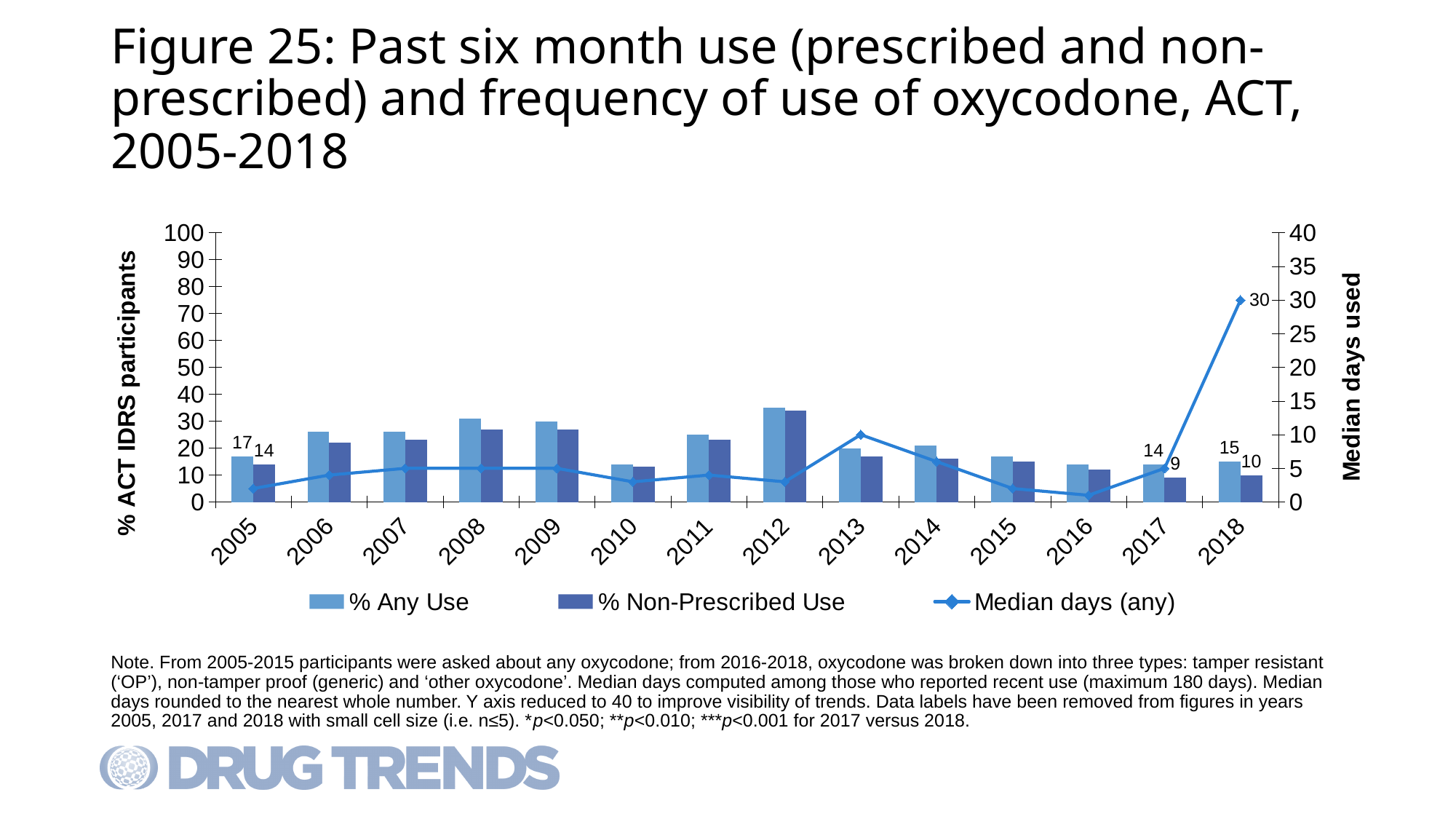
Which year has the larger Median days (any) value, 2013 or 2018? 2018 What is the value for % Any Use in 2018? 15 Which year has the highest % Any Use? 2012 How many series does the legend list? 3 What is the difference between % Any Use and % Non-Prescribed Use in 2018? 5 What is the value for Median days (any) in 2018? 30 What is the value for % Non-Prescribed Use in 2017? 9 What is the difference between % Any Use and % Non-Prescribed Use in 2005? 3 Is the value for % Any Use in 2012 greater or less than 30? greater What kind of chart is this? Combined bar and line chart What is the value for % Any Use in 2005? 17 How many years are shown on the x axis? 14